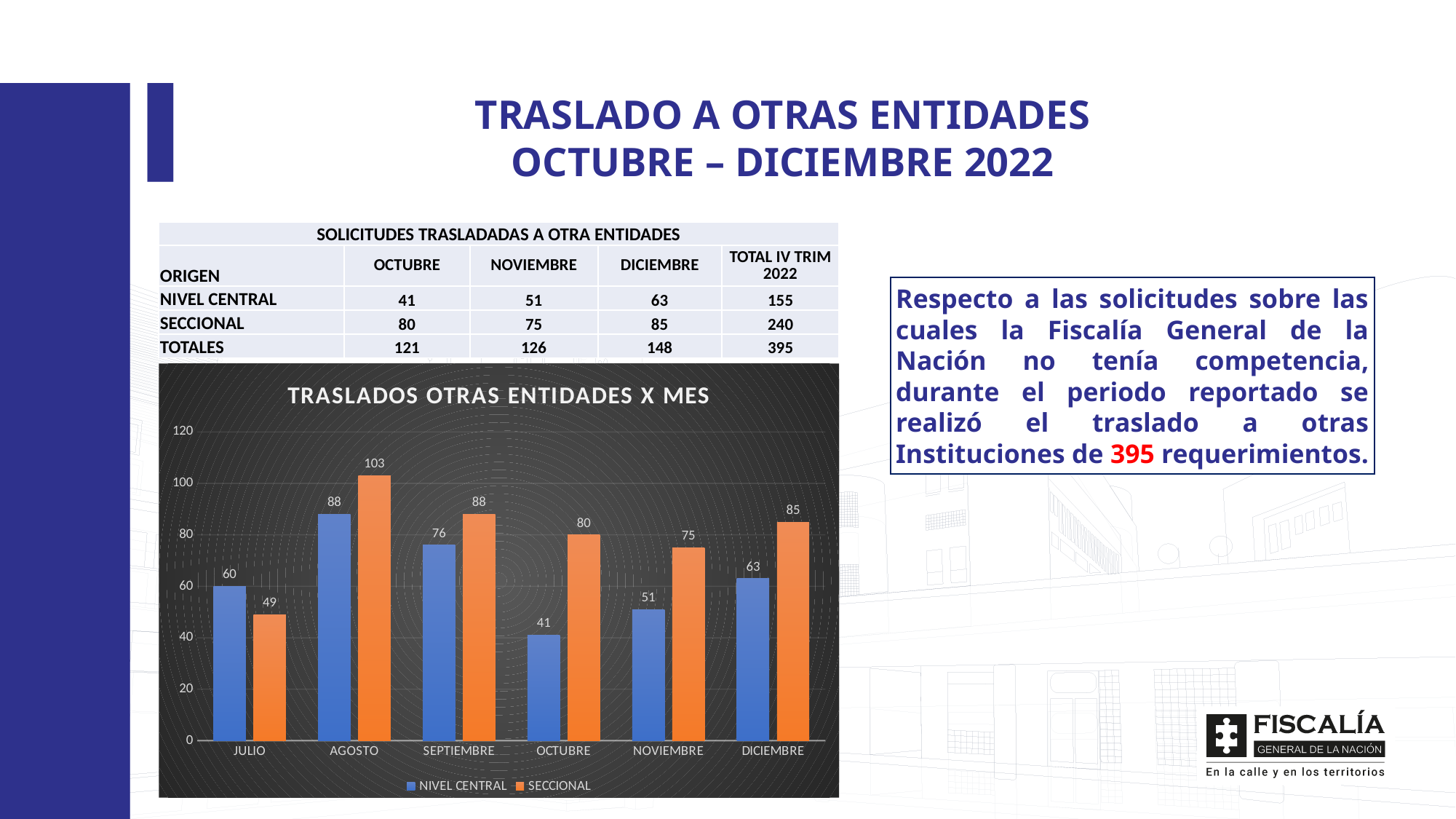
What type of chart is shown on the slide? Bar chart What is the difference between the SECCIONAL and NIVEL CENTRAL values for OCTUBRE? 39 How many months are shown on the x axis of the chart? 6 What is the SECCIONAL value for OCTUBRE? 80 Which month has the highest SECCIONAL value? AGOSTO How many series does the chart legend list? 2 Which is larger in JULIO, NIVEL CENTRAL or SECCIONAL? NIVEL CENTRAL Is the SECCIONAL value for AGOSTO greater or less than 100? greater What is the title of the chart? TRASLADOS OTRAS ENTIDADES X MES Which month has the lowest NIVEL CENTRAL value? OCTUBRE What is the NIVEL CENTRAL value for JULIO? 60 What is the NIVEL CENTRAL value for AGOSTO? 88